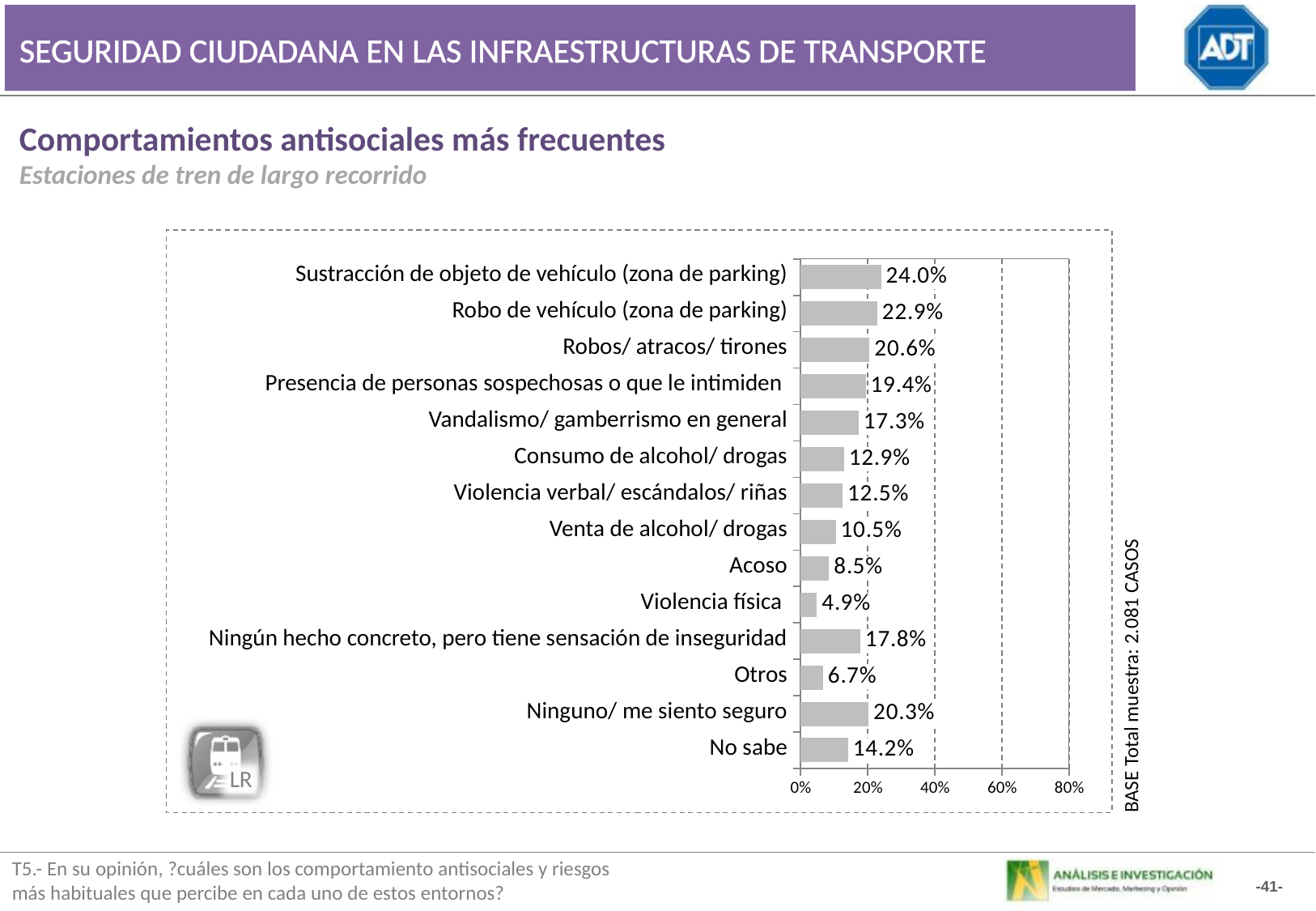
Is the value for "Vandalismo/ gamberrismo en general" greater or less than 20%? less Which category has the highest value? Sustracción de objeto de vehículo (zona de parking) What is the value for "Sustracción de objeto de vehículo (zona de parking)"? 24.0% What kind of chart is shown on the slide? bar chart What is the value for "Violencia física"? 4.9% What is the difference between "Robo de vehículo (zona de parking)" and "Robos/ atracos/ tirones"? 2.3% Which category has the lowest value? Violencia física Which is larger: "Consumo de alcohol/ drogas" or "Venta de alcohol/ drogas"? Consumo de alcohol/ drogas What is the base (total sample) stated next to the chart? 2.081 CASOS How many categories are shown in the chart? 14 What is the difference between "Acoso" and "Otros"? 1.8% What is the value for "Ninguno/ me siento seguro"? 20.3%